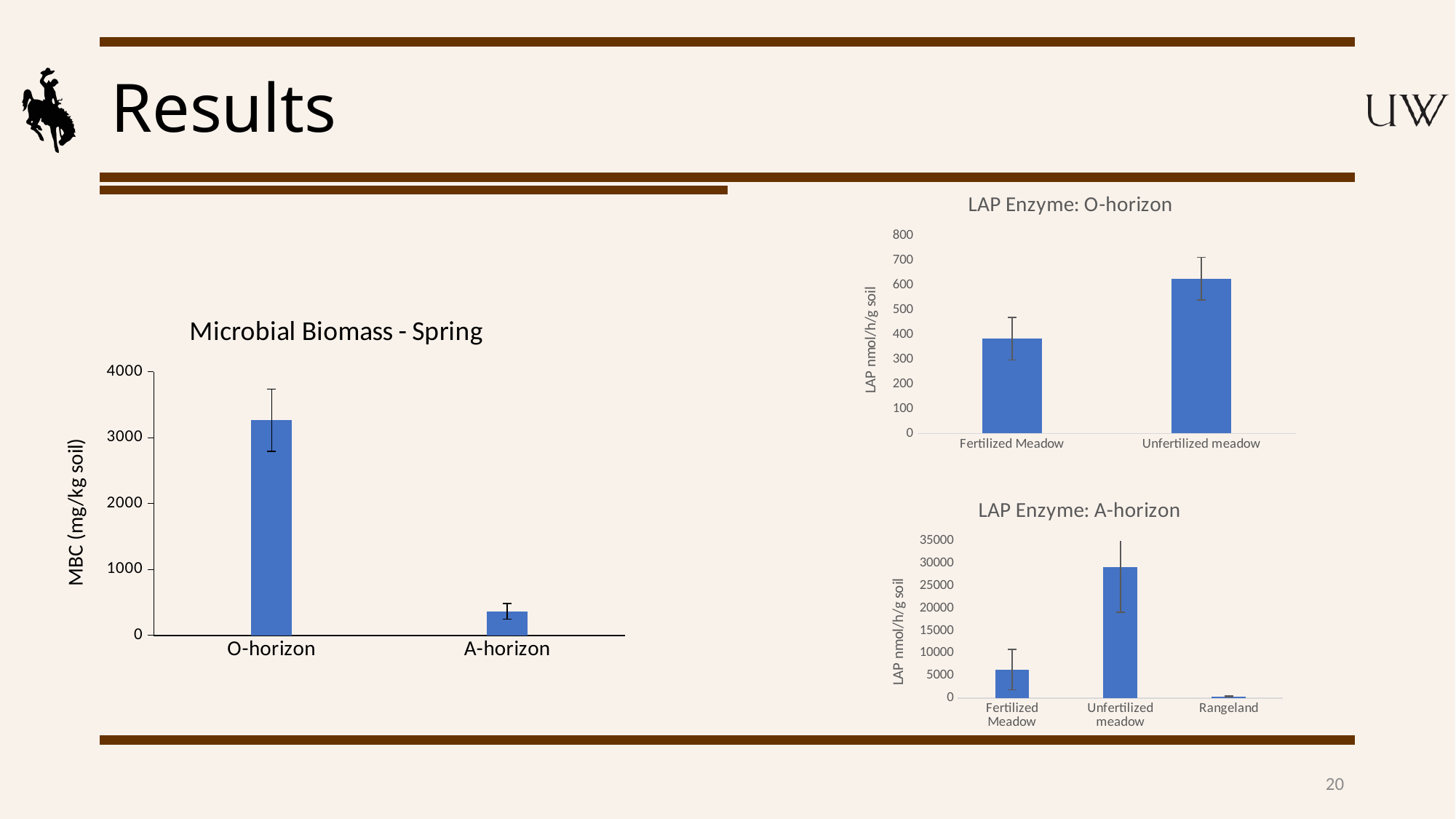
In the 'LAP Enzyme: A-horizon' chart, which category has the lowest value? Rangeland What kind of chart is the 'LAP Enzyme: A-horizon' chart? Bar chart In the 'LAP Enzyme: O-horizon' chart, is the value for Fertilized Meadow greater or less than 500? less What is the y-axis label of the 'Microbial Biomass - Spring' chart? MBC (mg/kg soil) In the 'LAP Enzyme: A-horizon' chart, is the value for Fertilized Meadow greater or less than 10000? less In the 'LAP Enzyme: A-horizon' chart, which category has the highest value? Unfertilized meadow In the 'Microbial Biomass - Spring' chart, is the value for A-horizon greater or less than 1000? less In the 'Microbial Biomass - Spring' chart, how many categories are shown on the x axis? 2 In the 'Microbial Biomass - Spring' chart, which category has the highest value? O-horizon In the 'LAP Enzyme: O-horizon' chart, which category has the lowest value? Fertilized Meadow